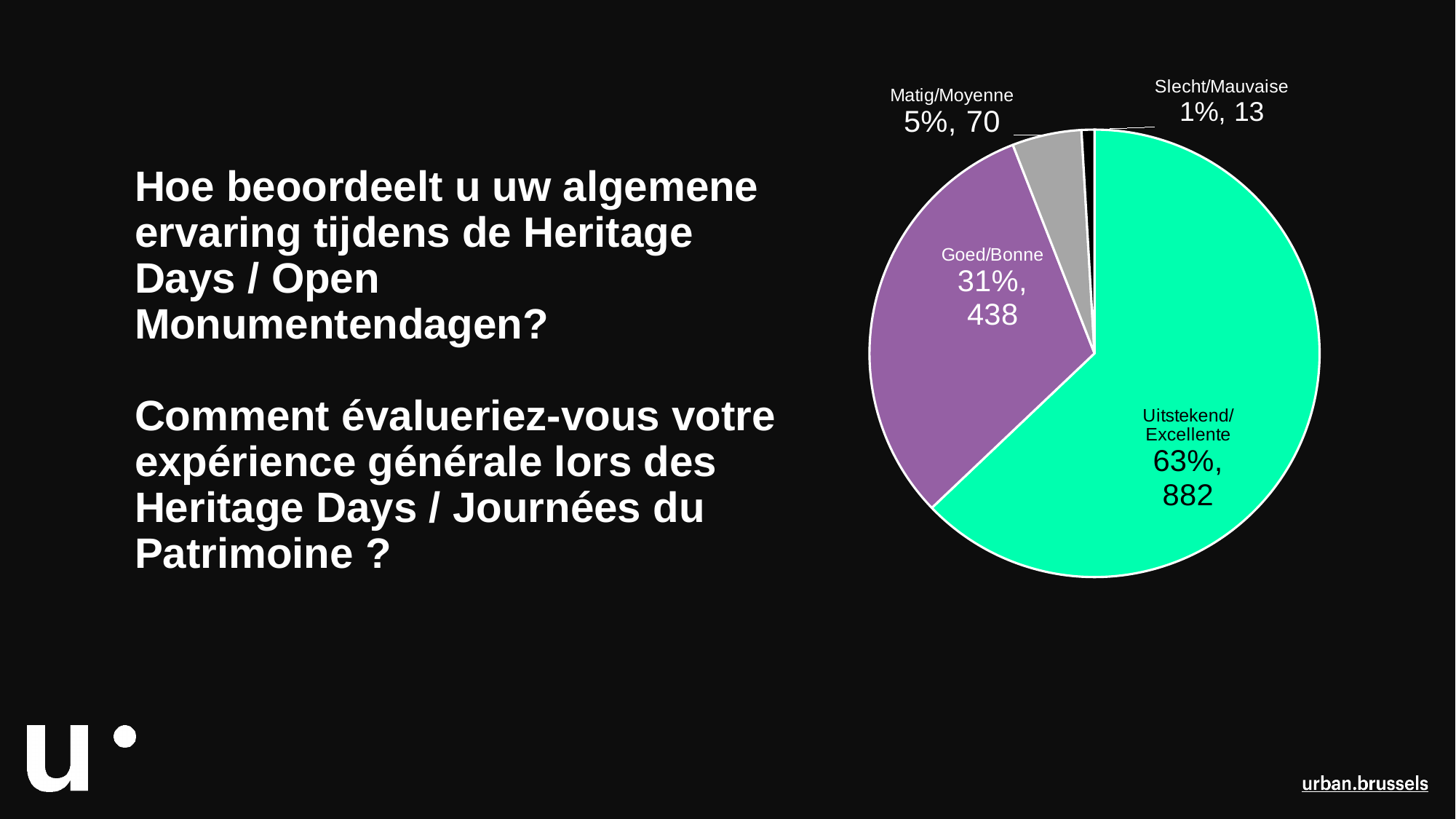
Which category has the smallest slice? Slecht/Mauvaise How many slices does the pie chart have? 4 What is the difference in count between Uitstekend/Excellente and Goed/Bonne? 444 What is the total count across all four slices? 1403 What percentage share does Slecht/Mauvaise have? 1% What colour is the Goed/Bonne slice? purple Which category has the largest slice? Uitstekend/Excellente What kind of chart is shown on the slide? pie chart Which has a larger count, Matig/Moyenne or Slecht/Mauvaise? Matig/Moyenne What is the count for Uitstekend/Excellente? 882 What is the count for Matig/Moyenne? 70 What percentage share does Goed/Bonne have? 31%